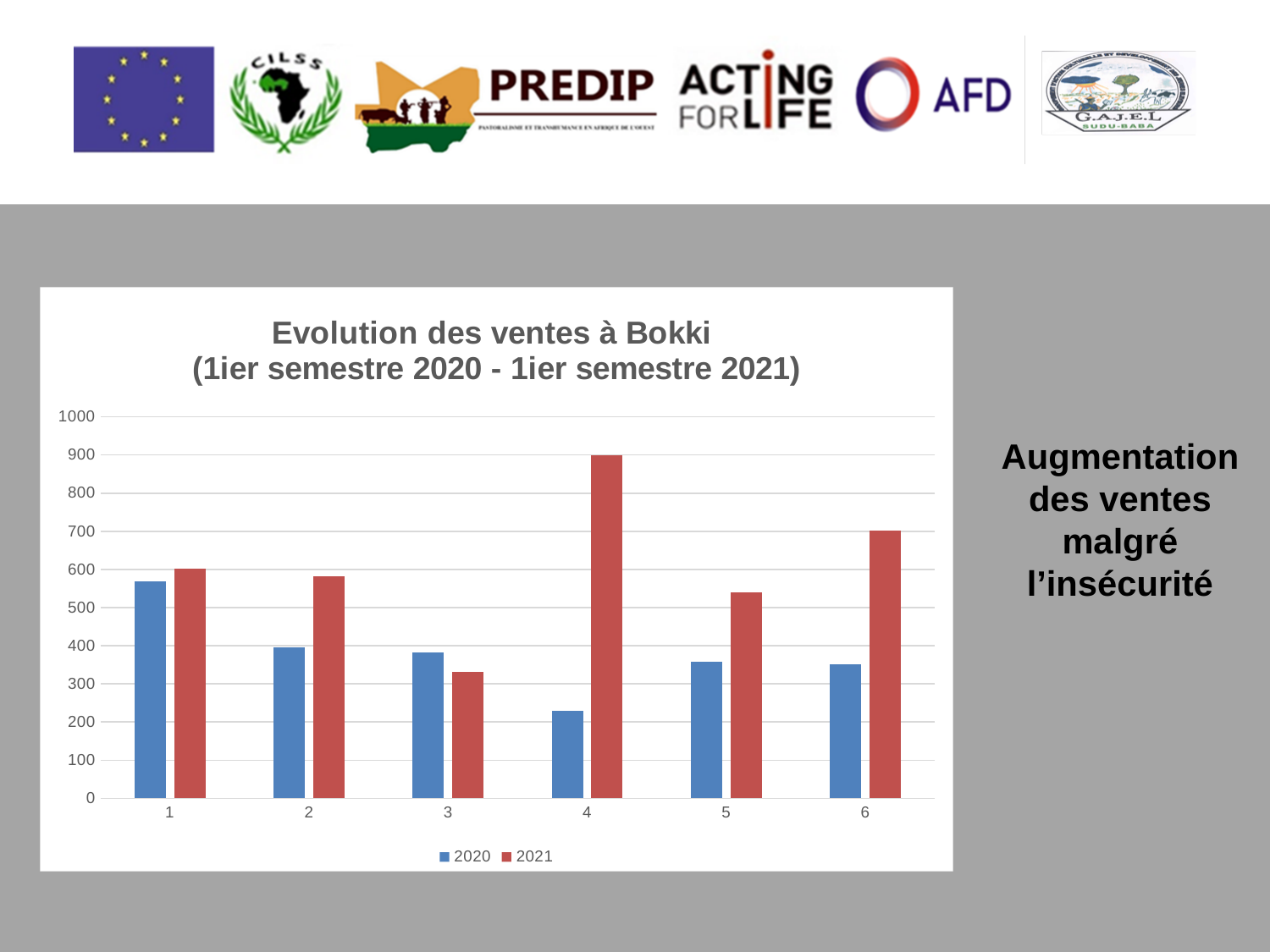
What is the title of the chart? Evolution des ventes à Bokki (1ier semestre 2020 - 1ier semestre 2021) Which category has the highest value for the 2021 series? 4 Which category has the lowest value for the 2020 series? 4 In category 4, which series has the larger value, 2020 or 2021? 2021 How many categories are shown on the x axis? 6 Is the value for 2021 in category 3 greater or less than 400? less Is the value for 2020 in category 4 greater or less than 300? less In category 3, which series has the larger value, 2020 or 2021? 2020 Is the value for 2021 in category 4 greater or less than 800? greater What are the two entries in the chart legend? 2020 and 2021 How many series does the legend list? 2 What kind of chart is shown on the slide? Bar chart